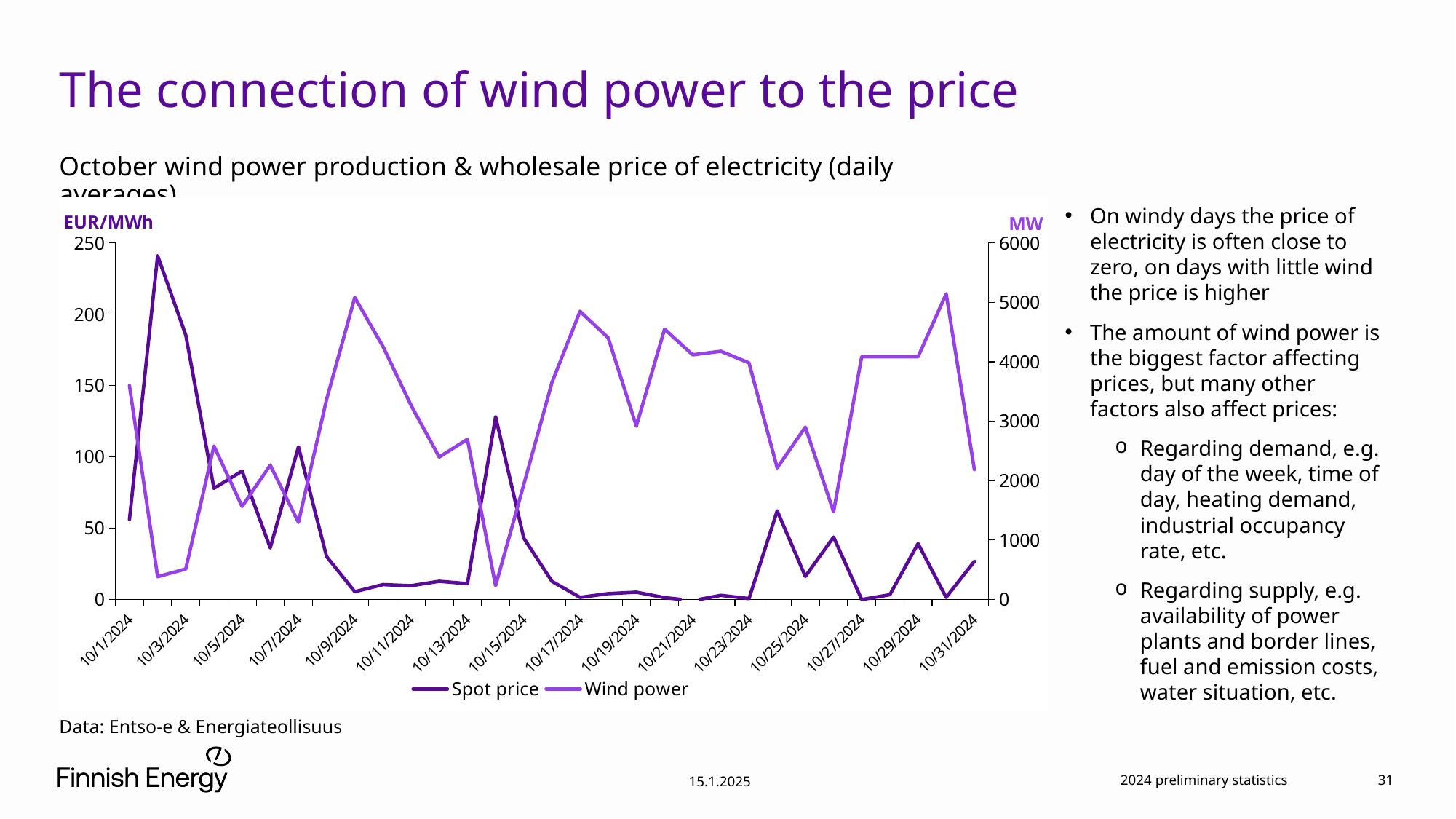
What are the two series named in the chart legend? Spot price and Wind power On which date does Wind power reach its highest value? 10/30/2024 On which date does the Spot price reach its highest value? 10/2/2024 What unit is shown on the left vertical axis of the chart? EUR/MWh Which is larger, the Spot price on 10/2/2024 or the Spot price on 10/16/2024? 10/2/2024 How many date labels are shown on the x axis of the chart? 16 Is the Spot price on 10/2/2024 greater or less than 200? greater Is the Spot price on 10/21/2024 greater or less than 50? less Is the Wind power value on 10/9/2024 greater or less than 4000? greater What kind of chart is shown on the slide? line chart Does the Spot price rise or fall between 10/2/2024 and 10/9/2024? fall How many series does the chart legend list? 2